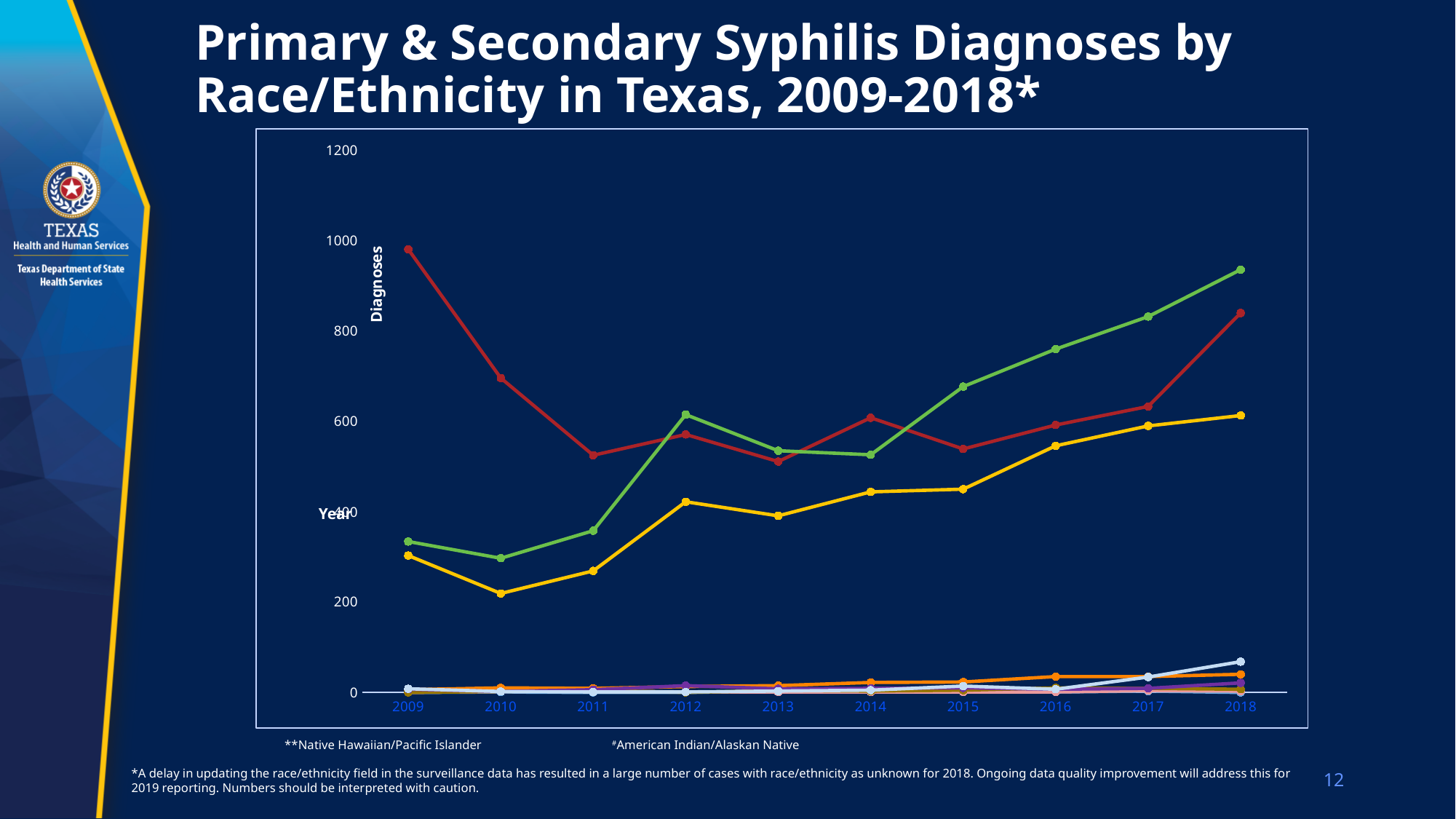
What is the label on the vertical axis? Diagnoses In 2009, which line is higher, the red line or the green line? red line In which year does the red line reach its highest value? 2009 How many years are plotted along the x axis? 10 Is the value of the yellow line in 2016 greater or less than 400? greater What kind of chart is shown on the slide? line chart Is the value of the green line in 2018 greater or less than 800? greater Is the value of the red line in 2009 greater or less than 800? greater Does the green line rise or fall from 2014 to 2018? rise In 2018, which line is higher, the green line or the yellow line? green line